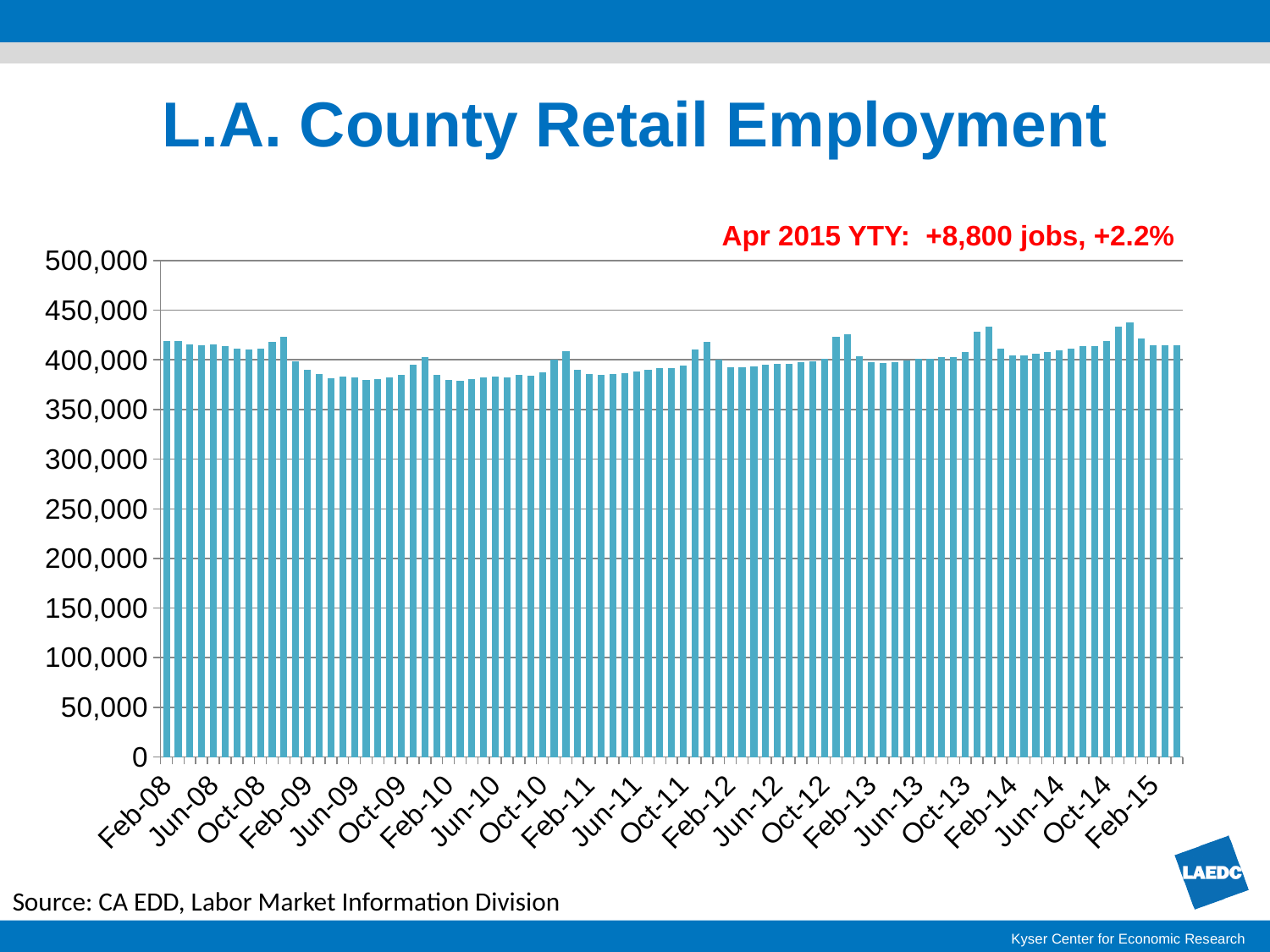
Do the values generally rise or fall from Feb-08 to Feb-10? fall Do the values generally rise or fall from Feb-10 to Feb-15? rise Which is larger, the value for Feb-08 or the value for Feb-10? Feb-08 Is the value for Jun-09 greater or less than 400,000? less What is the title of the chart? L.A. County Retail Employment Is the value for Oct-14 greater or less than 400,000? greater Is the value for Feb-10 greater or less than 350,000? greater What kind of chart is shown on the slide? bar chart According to the annotation on the chart, what was the April 2015 year-to-year change in jobs? +8,800 jobs, +2.2% Which is larger, the value for Feb-15 or the value for Feb-10? Feb-15